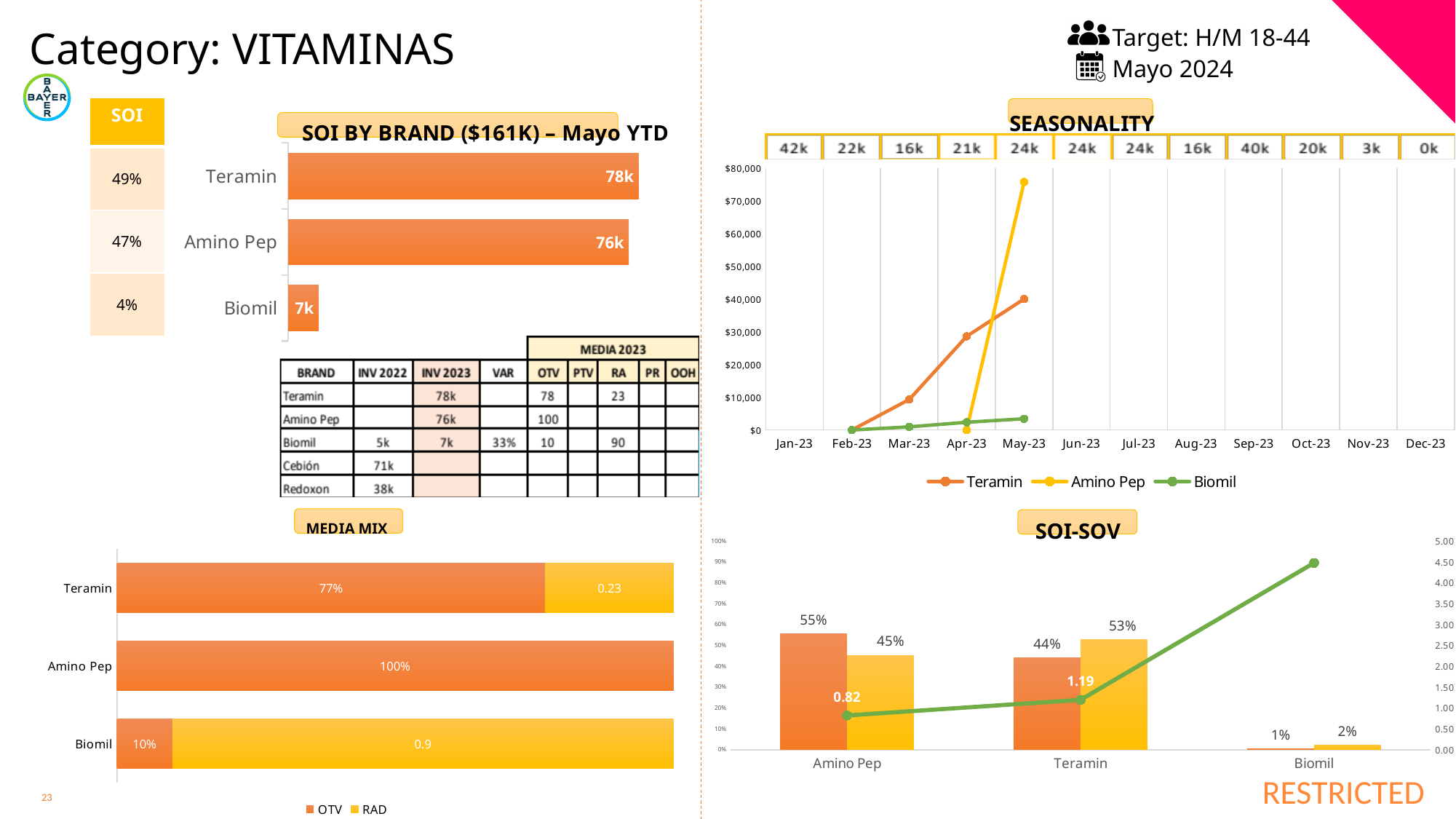
In the SOI-SOV chart, what is the orange bar value for Teramin? 44% In the SOI-SOV chart, which is larger for Amino Pep: the orange bar (55%) or the yellow bar (45%)? The orange bar (55%) In the SEASONALITY chart, does the Teramin line rise or fall from Feb-23 to May-23? Rises In the SOI BY BRAND chart, what is the value for Teramin? 78k In the MEDIA MIX chart, what is the RAD value for Teramin? 0.23 In the SOI BY BRAND chart, what is the difference between Teramin and Amino Pep? 2k In the SEASONALITY chart, is the value for Amino Pep in May-23 greater or less than $70,000? greater In the SOI BY BRAND chart, which brand has the lowest value? Biomil How many series does the legend of the MEDIA MIX chart list? 2 What kind of chart is the SEASONALITY chart? Line chart In the MEDIA MIX chart, what is the OTV value for Biomil? 10% How many brands are shown in the SOI BY BRAND chart? 3